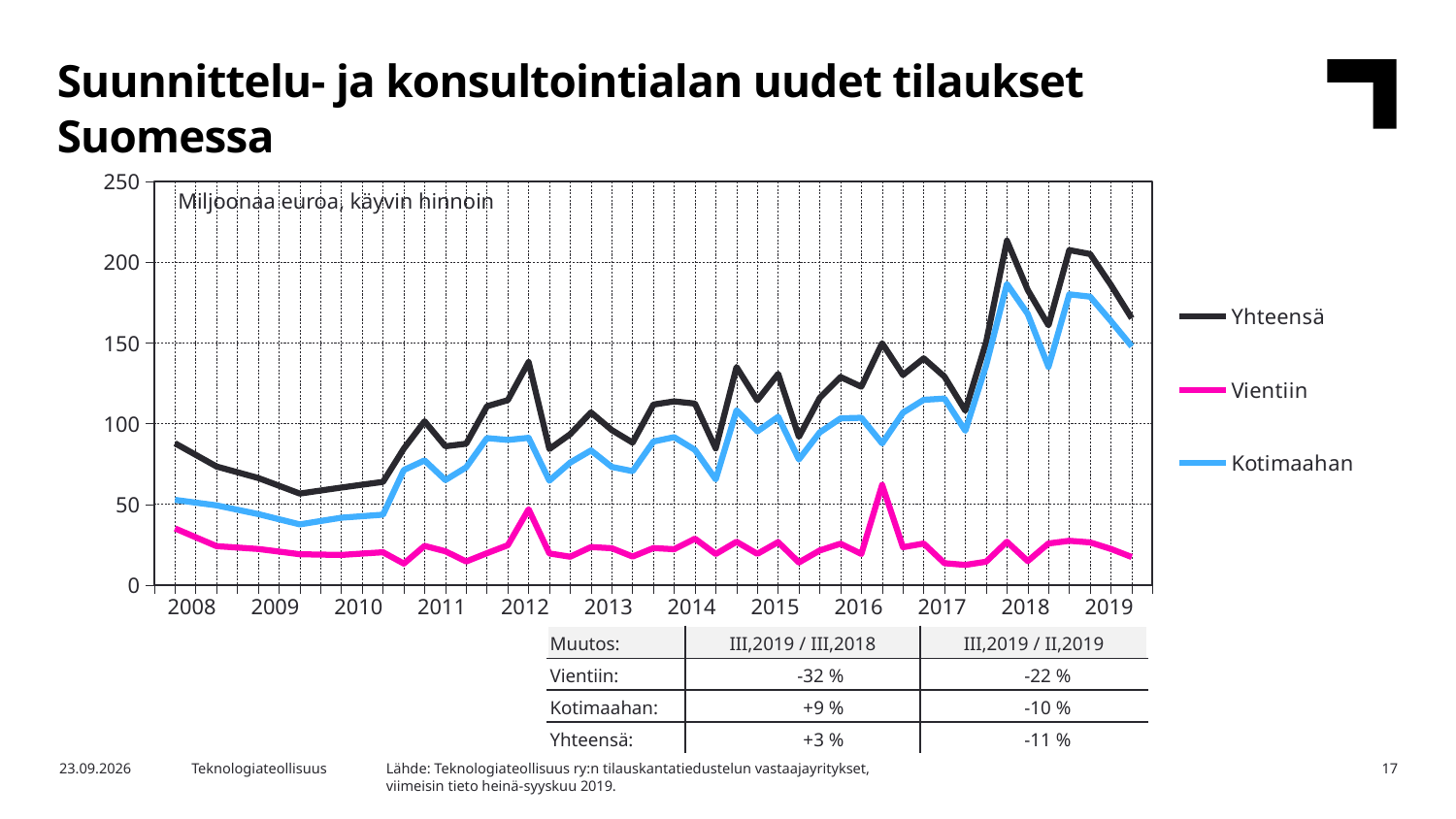
Is the peak value of the Vientiin line in 2016 greater or less than 50? greater Is the peak value of the Yhteensä line in late 2017 greater or less than 200? greater What are the three series named in the chart legend? Yhteensä, Vientiin, Kotimaahan Which series is larger at the end of 2017, Kotimaahan or Vientiin? Kotimaahan Which series has the lowest values throughout the chart? Vientiin How many series does the chart legend list? 3 Is the value of the Yhteensä line at the start of 2008 greater or less than 100? less Which series has the highest values throughout the chart? Yhteensä How many years are labelled on the x axis of the chart? 12 What unit is stated in the text inside the chart area? Miljoonaa euroa, käyvin hinnoin What type of chart is shown on the slide? line chart